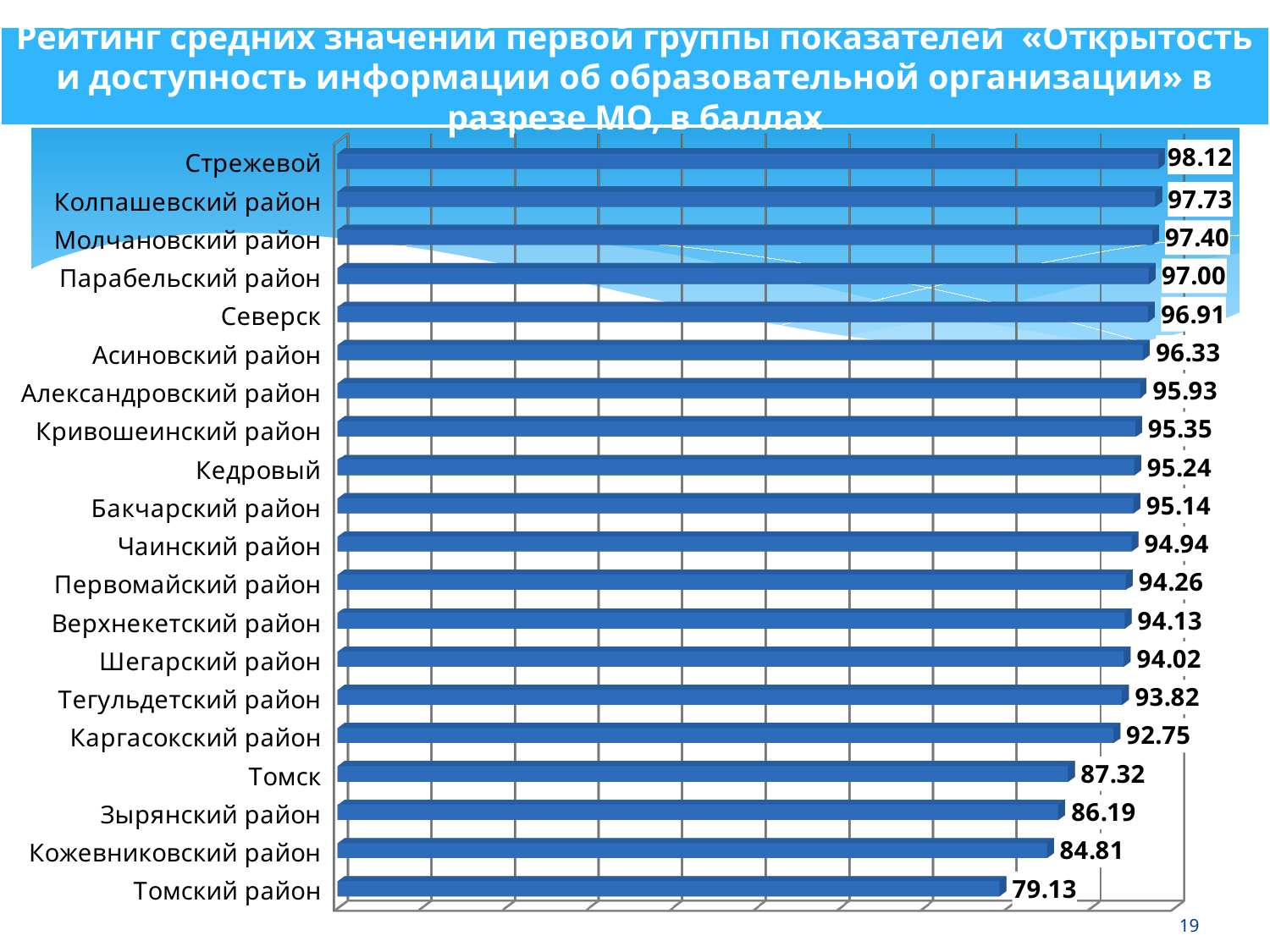
What is the value for Каргасокский район? 92.75 What is the value for Томск? 87.32 What is the value for Стрежевой? 98.12 What is the difference between the values for Томск and Томский район? 8.19 Which has a larger value, Зырянский район or Кожевниковский район? Зырянский район Which category has the lowest value? Томский район How many categories are shown in the chart? 20 What kind of chart is shown on the slide? Bar chart What is the value for Кедровый? 95.24 What is the difference between the values for Стрежевой and Томский район? 18.99 Which category has the highest value? Стрежевой Which has a larger value, Северск or Томск? Северск